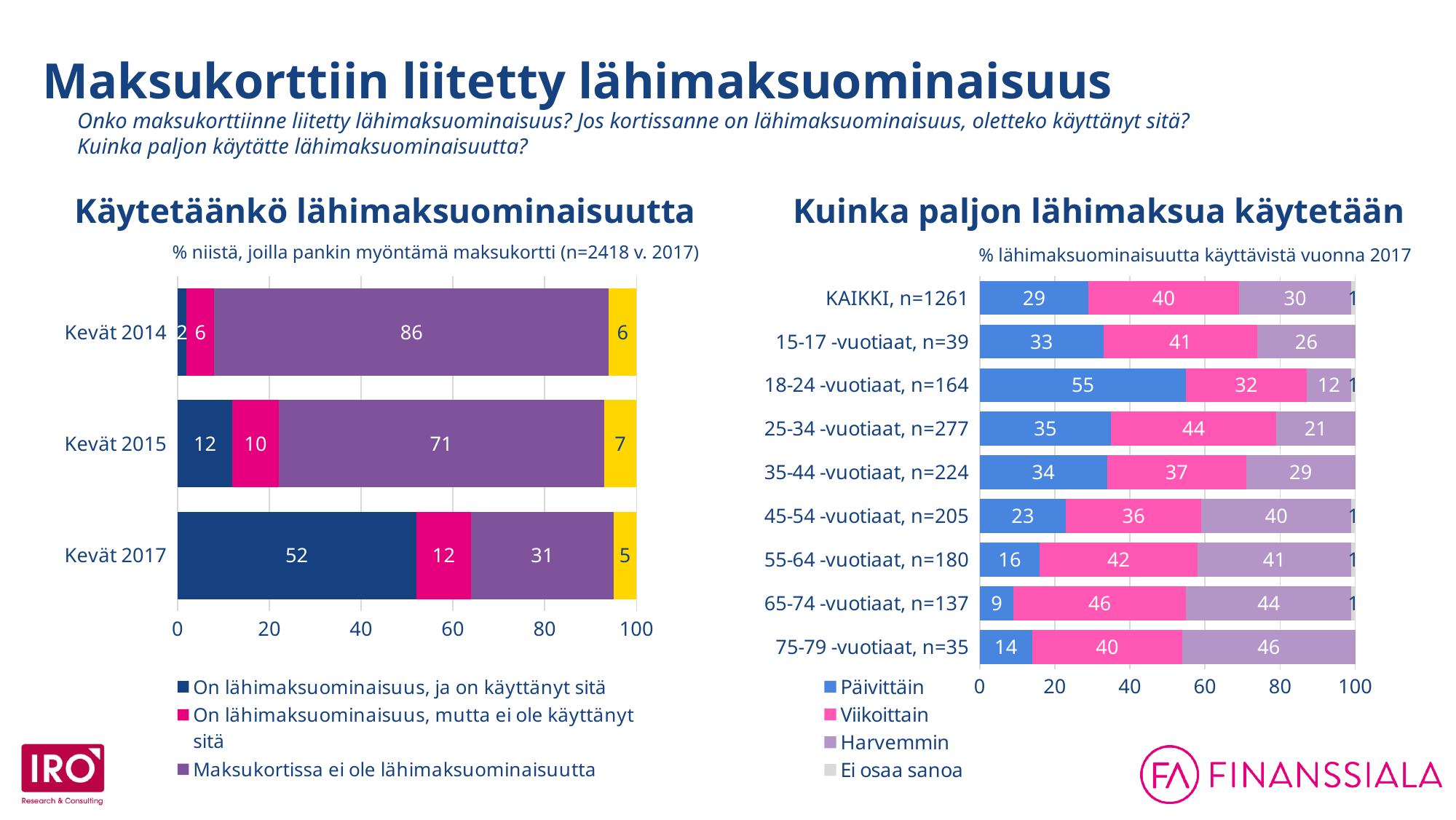
In the chart 'Kuinka paljon lähimaksua käytetään', what is the 'Päivittäin' value for 18-24 -vuotiaat? 55 How many years are shown in the chart 'Käytetäänkö lähimaksuominaisuutta'? 3 In the chart 'Kuinka paljon lähimaksua käytetään', which age group has the lowest 'Päivittäin' value? 65-74 -vuotiaat In the chart 'Kuinka paljon lähimaksua käytetään', what is the 'Viikoittain' value for KAIKKI, n=1261? 40 What type of chart is 'Kuinka paljon lähimaksua käytetään'? stacked bar chart In the chart 'Käytetäänkö lähimaksuominaisuutta', how much did the value for 'Maksukortissa ei ole lähimaksuominaisuutta' fall from Kevät 2015 to Kevät 2017? 40 In the chart 'Käytetäänkö lähimaksuominaisuutta', does the value for 'Maksukortissa ei ole lähimaksuominaisuutta' rise or fall from Kevät 2014 to Kevät 2017? fall How many series does the legend of the chart 'Kuinka paljon lähimaksua käytetään' list? 4 In the chart 'Kuinka paljon lähimaksua käytetään', which is larger: the 'Harvemmin' value for 75-79 -vuotiaat or for 45-54 -vuotiaat? 75-79 -vuotiaat In the chart 'Käytetäänkö lähimaksuominaisuutta', what is the value for 'Maksukortissa ei ole lähimaksuominaisuutta' in Kevät 2014? 86 In the chart 'Käytetäänkö lähimaksuominaisuutta', what is the value for 'On lähimaksuominaisuus, ja on käyttänyt sitä' in Kevät 2017? 52 In the chart 'Käytetäänkö lähimaksuominaisuutta', which year has the highest value for 'On lähimaksuominaisuus, ja on käyttänyt sitä'? Kevät 2017